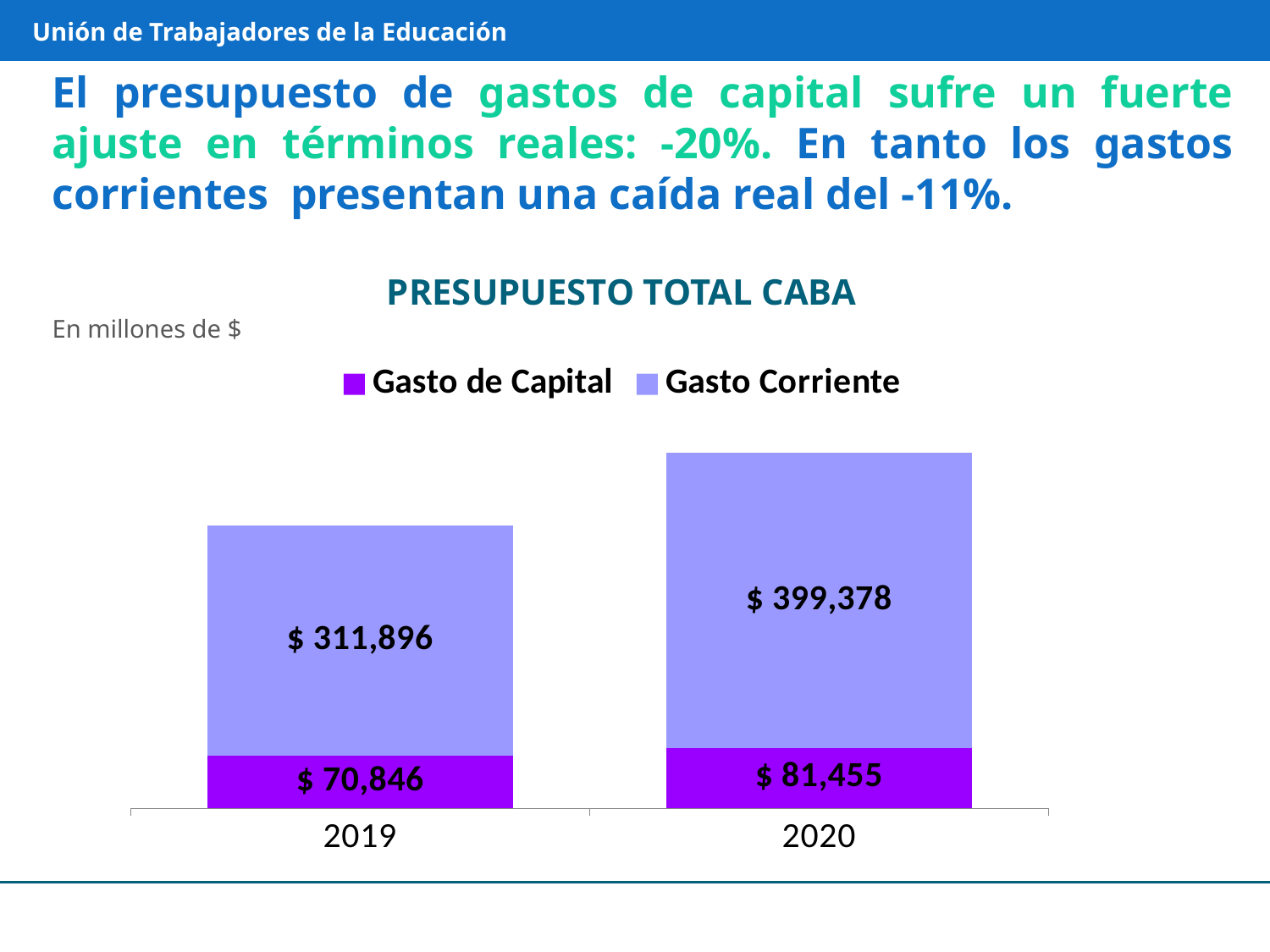
What is the difference between Gasto de Capital in 2020 and in 2019? $ 10,609 What type of chart is shown on the slide? Stacked bar chart Which year has the lower Gasto de Capital value? 2019 What is the value of Gasto Corriente for 2020? $ 399,378 What is the value of Gasto de Capital for 2019? $ 70,846 What is the total of the stacked bar for 2019? $ 382,742 What is the difference between Gasto Corriente in 2020 and in 2019? $ 87,482 How many series does the legend list? 2 What is the value of Gasto de Capital for 2020? $ 81,455 What is the total of the stacked bar for 2020? $ 480,833 Which year has the higher Gasto Corriente value? 2020 What is the value of Gasto Corriente for 2019? $ 311,896